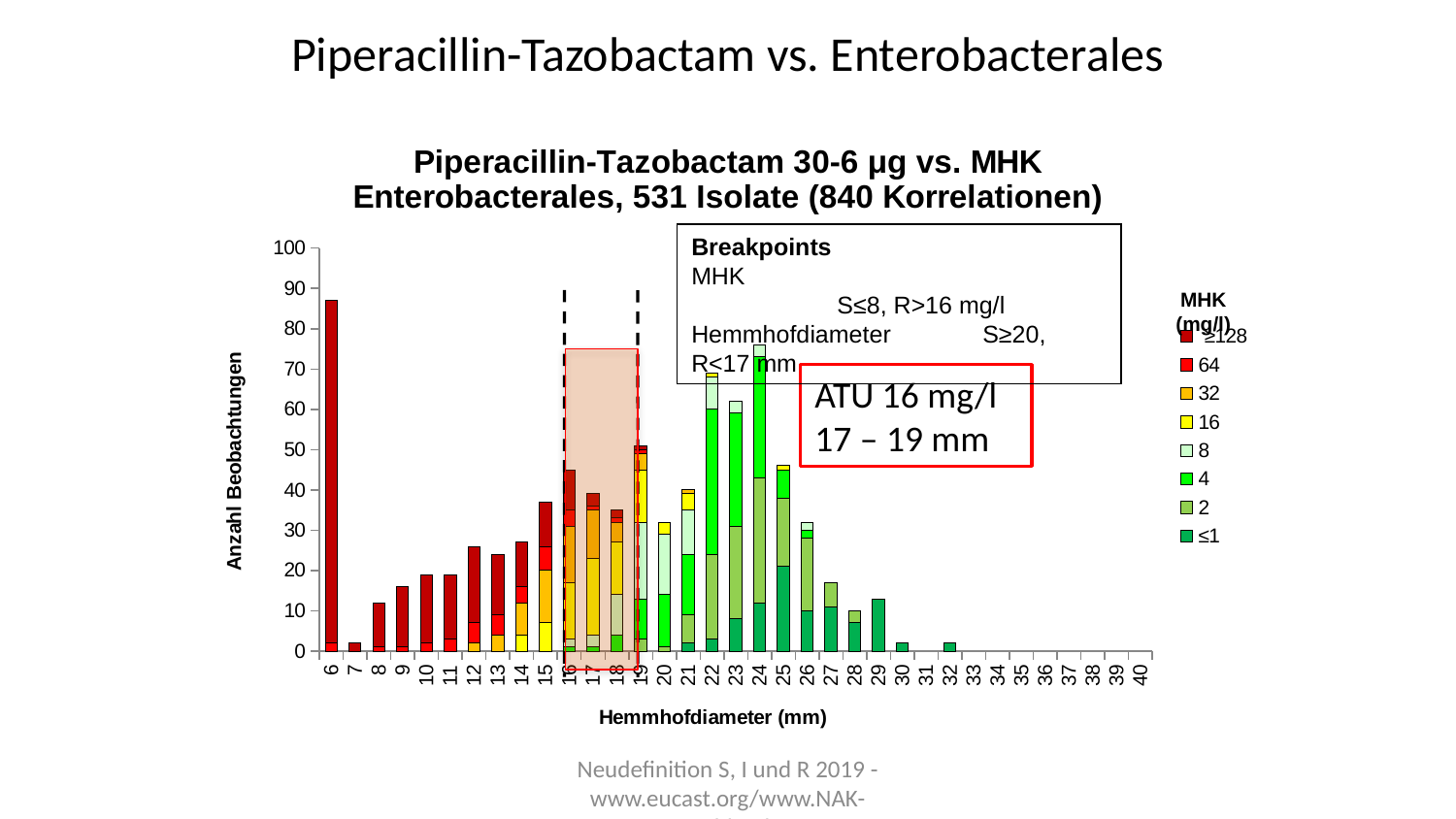
Which bar is taller, the one at 20 mm or the one at 21 mm? 21 mm Is the bar for a Hemmhofdiameter of 24 mm greater or less than 70? greater Which Hemmhofdiameter value has the tallest bar? 6 What is the label of the y axis? Anzahl Beobachtungen Is the bar for a Hemmhofdiameter of 25 mm greater or less than 50? less Between 24 mm and 28 mm, do the bar heights rise or fall as the Hemmhofdiameter increases? fall Which bar is taller, the one at 6 mm or the one at 24 mm? 6 mm What kind of chart is shown on the slide? Stacked bar chart What is the title of the chart? Piperacillin-Tazobactam 30-6 µg vs. MHK Enterobacterales, 531 Isolate (840 Korrelationen) Is the bar for a Hemmhofdiameter of 7 mm greater or less than 10? less How many MHK (mg/l) entries does the legend list? 8